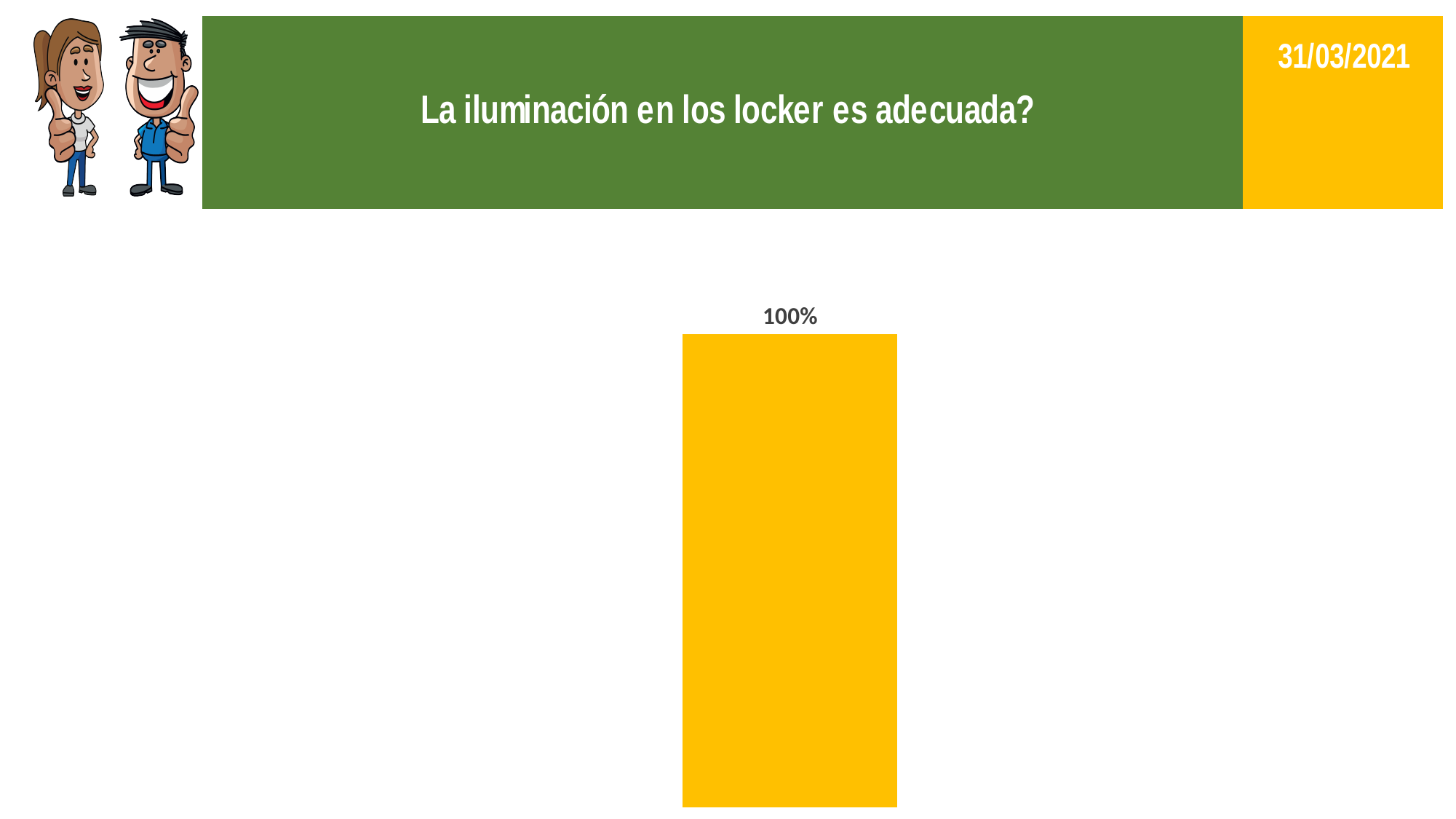
How many bars are plotted in the chart? 1 What value is printed as the data label above the bar? 100% What colour is the bar in the chart? yellow What kind of chart is shown on the slide? bar chart What question is written in the green header above the chart? La iluminación en los locker es adecuada?